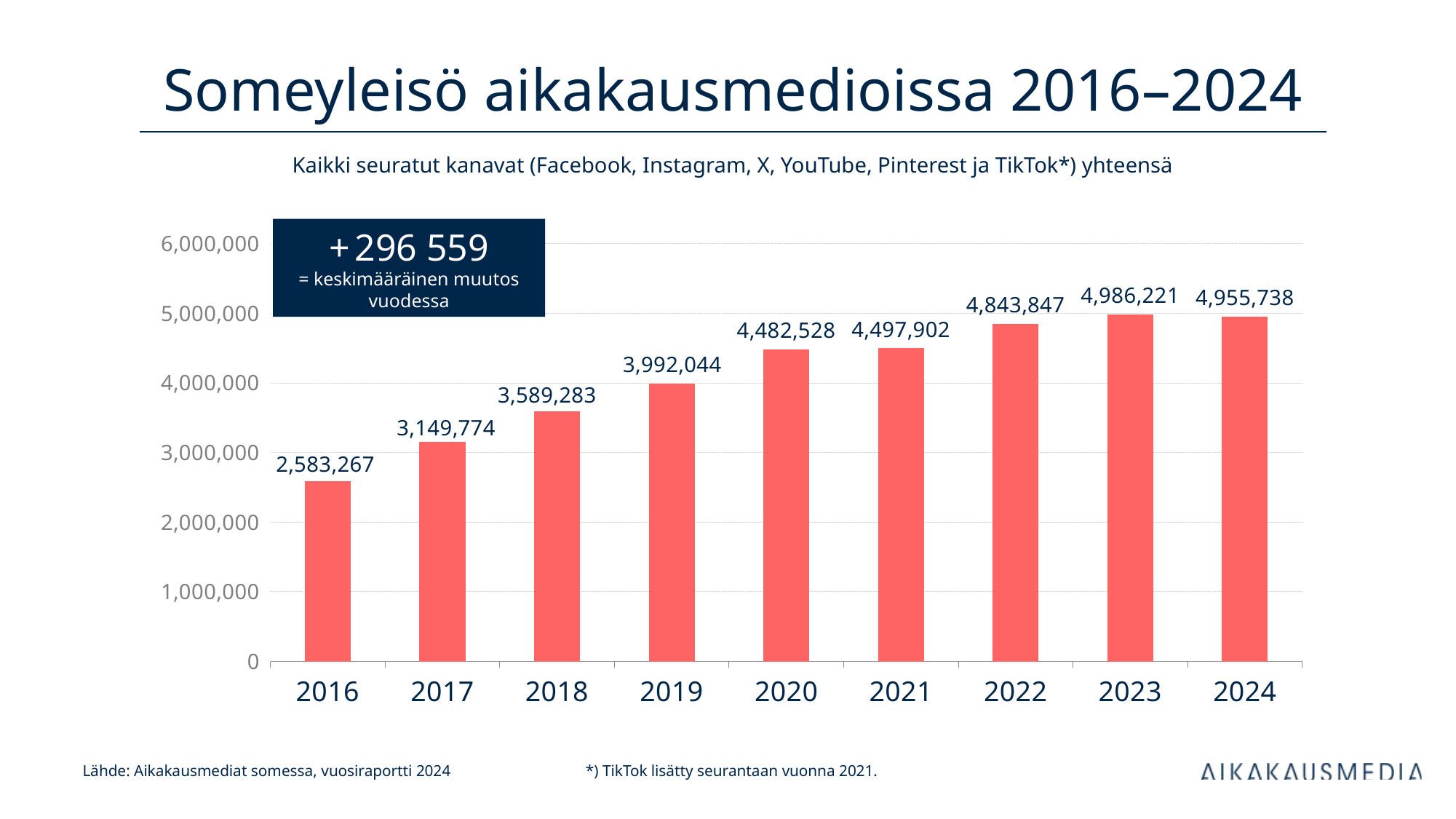
Which year has the highest value? 2023 What is the value for 2020? 4,482,528 What is the value for 2016? 2,583,267 What is the difference between the values for 2024 and 2016? 2,372,471 Which is larger, the value for 2020 or the value for 2021? 2021 Which year has the lowest value? 2016 Do the values rise or fall from 2016 to 2020? rise What kind of chart is shown on the slide? bar chart How many years are shown on the x axis? 9 What is the value for 2024? 4,955,738 What is the difference between the values for 2023 and 2022? 142,374 Is the value for 2018 greater or less than 4,000,000? less